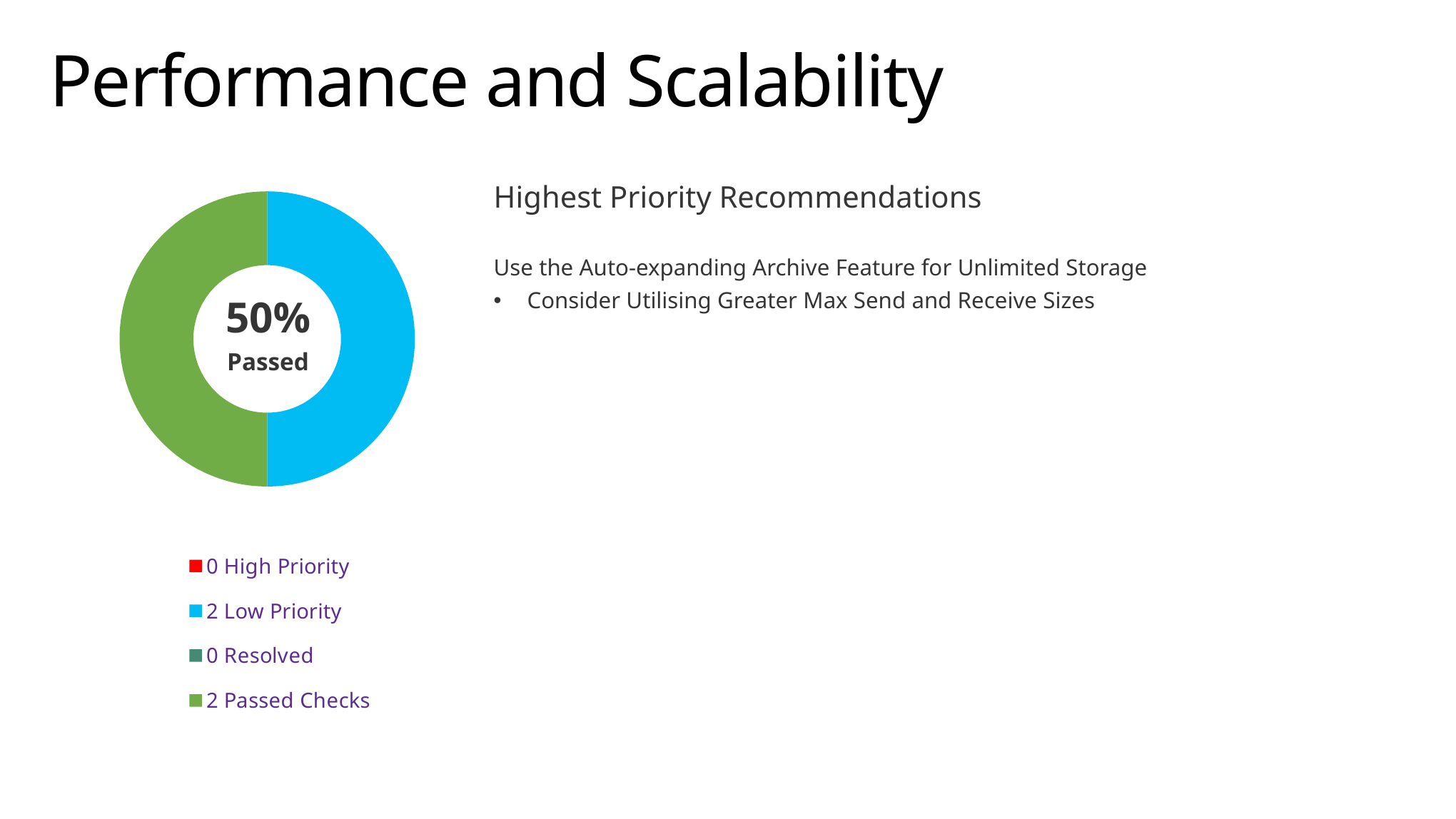
What is the difference between the number of Low Priority items and the number of High Priority items? 2 How many Passed Checks does the legend show? 2 Which colour represents Passed Checks in the chart? Green How many Resolved items does the legend show? 0 What percentage is shown in the centre of the donut chart? 50% How many entries does the chart legend list? 4 Which colour represents Low Priority in the chart? Blue What is the total of all the counts listed in the legend? 4 What share of the donut chart do the Passed Checks represent? 50% What kind of chart is shown on the slide? Donut chart How many High Priority items does the legend show? 0 How many Low Priority items does the legend show? 2